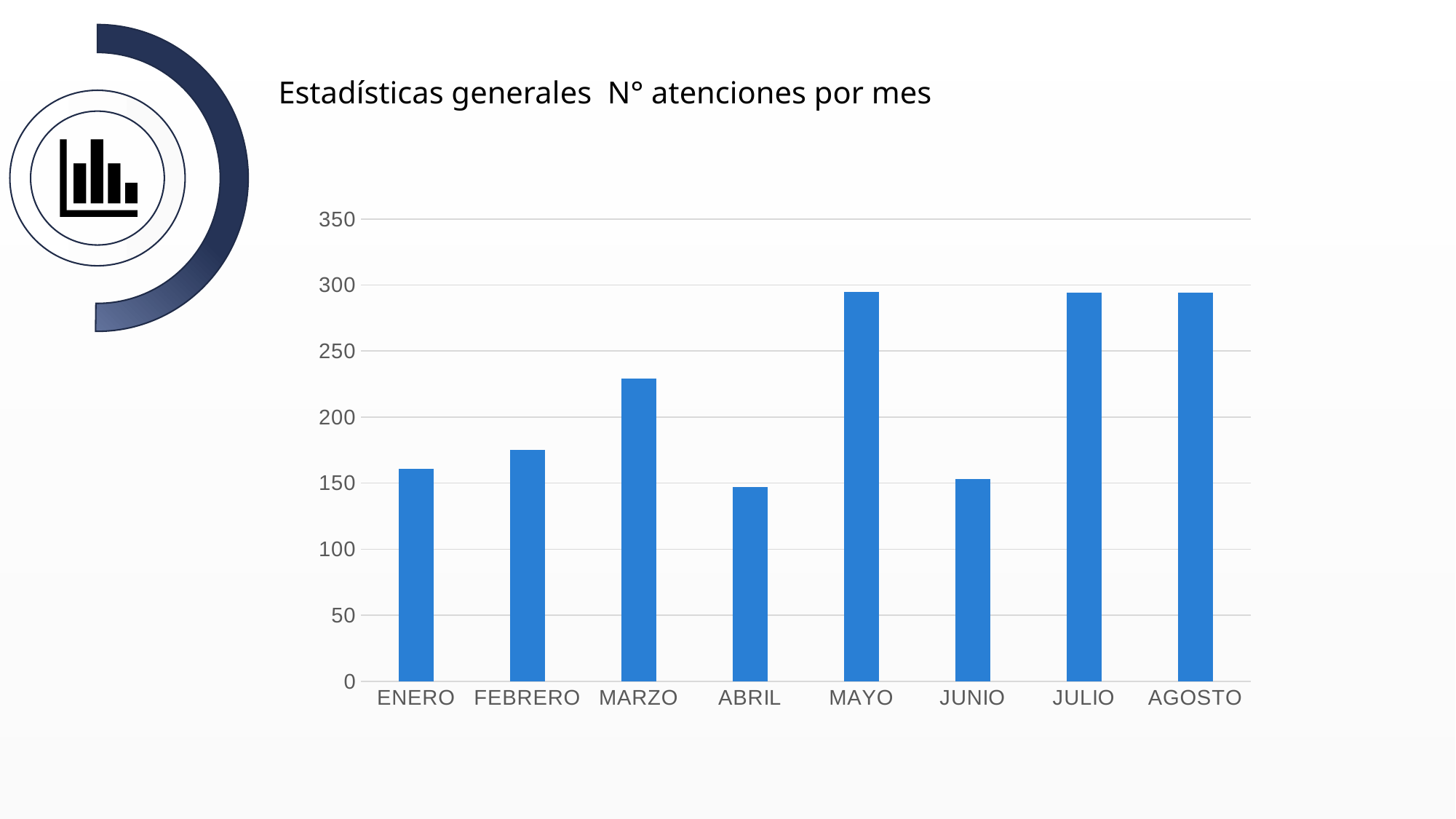
What kind of chart is shown on the slide? bar chart Is the value for MARZO greater or less than 200? greater Do the values rise or fall from ENERO to MARZO? rise Is the value for JULIO greater or less than 300? less Is the value for ENERO greater or less than 200? less Which is larger, the value for MARZO or the value for FEBRERO? MARZO How many months are shown on the x axis of the chart? 8 What is the title of the chart? Estadísticas generales N° atenciones por mes Which is larger, the value for AGOSTO or the value for JUNIO? AGOSTO